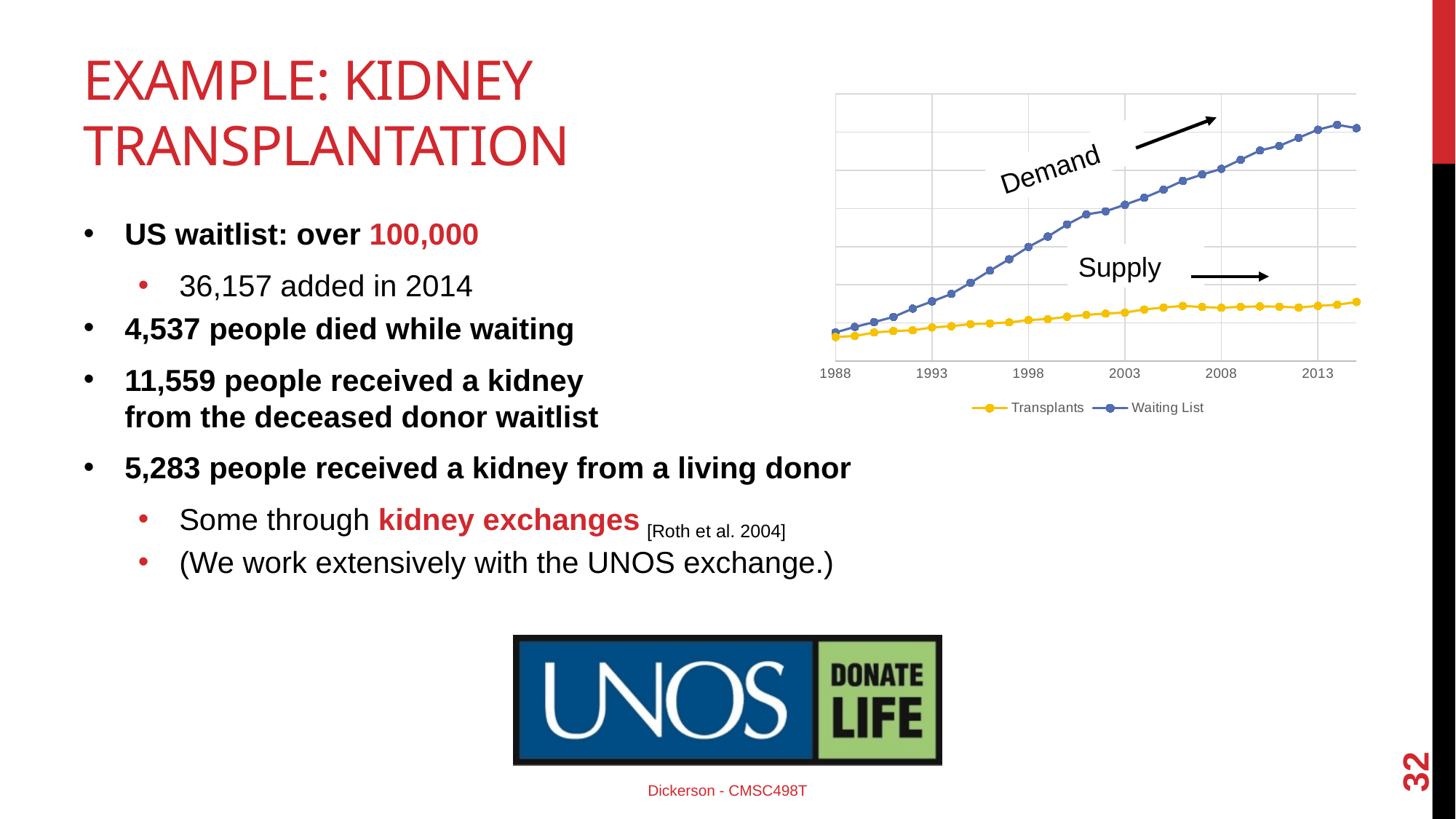
What is the last year labelled on the chart's x axis? 2013 Does the Transplants series rise or fall from 1988 to 2013? rise What is the first year labelled on the chart's x axis? 1988 In 2013, which series has the higher value, Transplants or Waiting List? Waiting List What kind of chart is shown on the slide? line chart How many series does the chart's legend list? 2 Does the Waiting List series rise or fall from 1988 to 2013? rise What are the two series named in the chart's legend? Transplants and Waiting List Which series reaches the highest point on the chart? Waiting List How many year labels are shown on the chart's x axis? 6 Which series stays lowest across the chart? Transplants Which series is drawn in blue in the chart? Waiting List